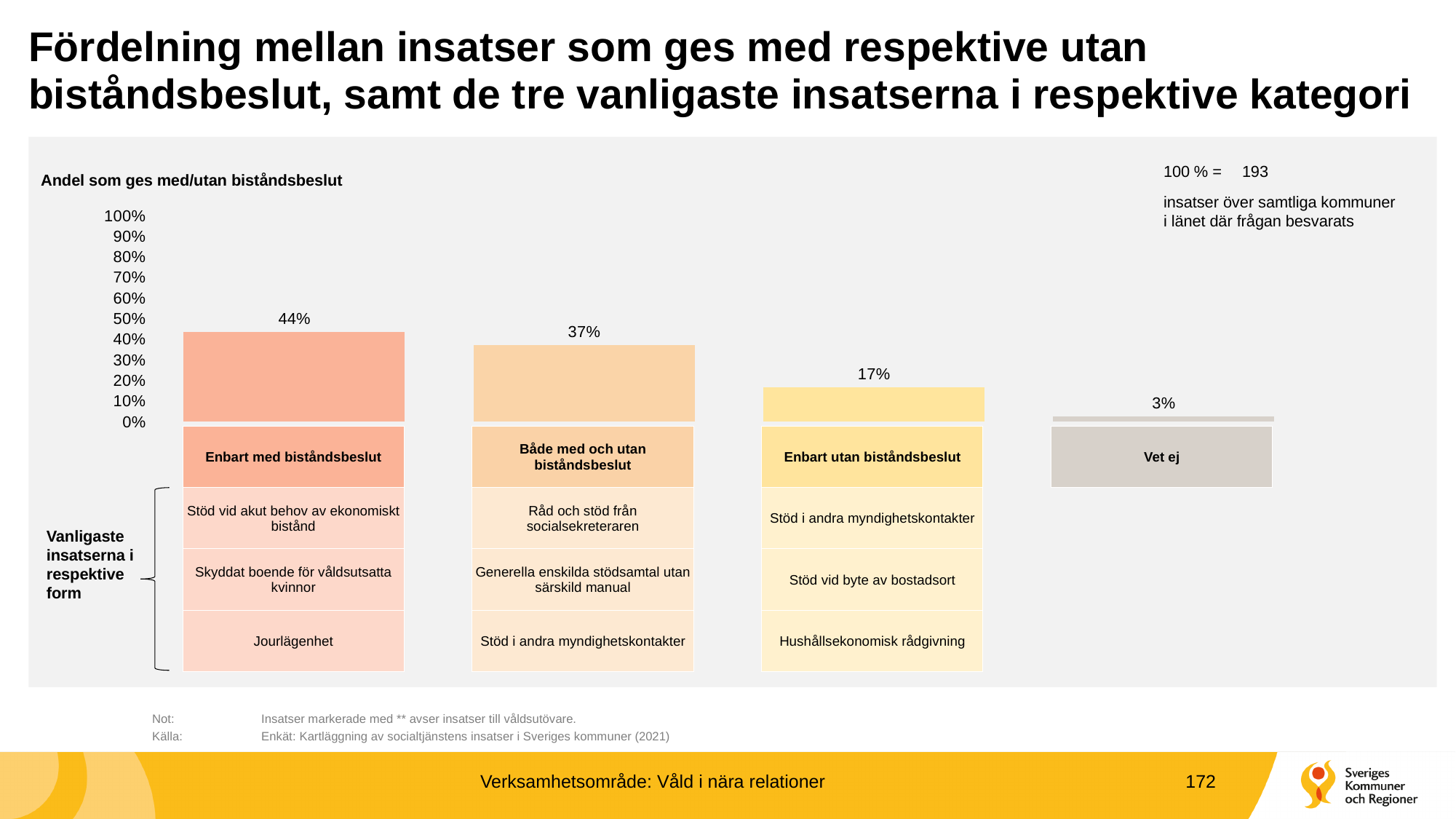
What is the value for "Enbart utan biståndsbeslut"? 17% Which category has the highest value? Enbart med biståndsbeslut What is the difference between "Enbart med biståndsbeslut" and "Både med och utan biståndsbeslut"? 7 percentage points Which is larger, "Enbart utan biståndsbeslut" or "Vet ej"? Enbart utan biståndsbeslut What is the value for "Vet ej"? 3% What is the value for "Både med och utan biståndsbeslut"? 37% Which category has the lowest value? Vet ej How many categories are shown in the chart? 4 Is the value for "Både med och utan biståndsbeslut" greater or less than 50%? less What kind of chart is shown on the slide? Bar chart What is the value for "Enbart med biståndsbeslut"? 44% What number of insatser corresponds to 100% in the chart? 193